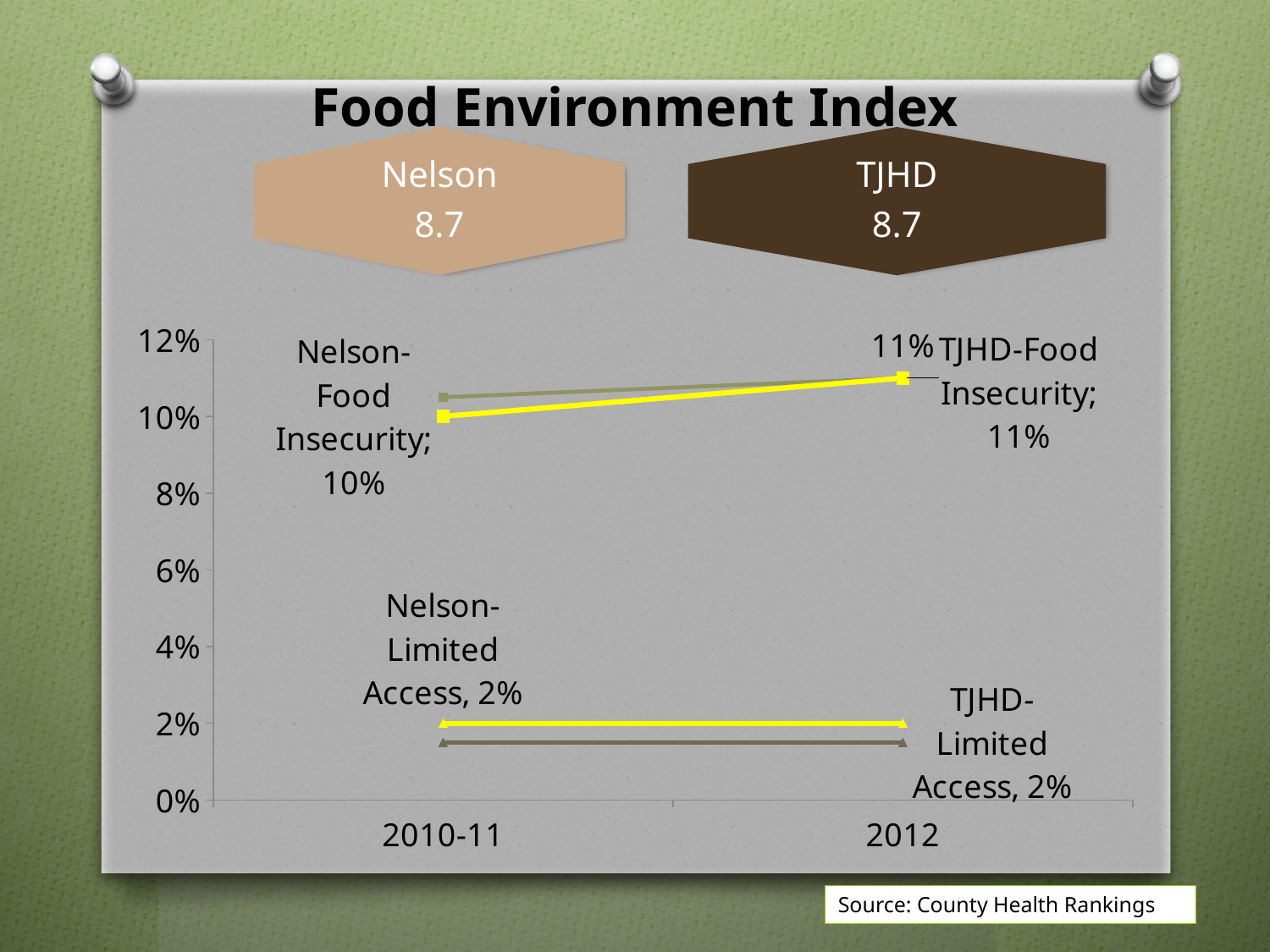
What is the TJHD Food Insecurity value for 2012? 11% What Food Environment Index value is shown for Nelson in the shape above the chart? 8.7 What is the Nelson Food Insecurity value for 2012? 11% What kind of chart is shown on the slide? line chart In 2010-11, which is larger for Nelson: Food Insecurity or Limited Access? Food Insecurity How many time periods are shown on the x axis? 2 What is the Nelson Limited Access value for 2010-11? 2% By how many percentage points did Nelson Food Insecurity change from 2010-11 (10%) to 2012 (11%)? 1 percentage point What is the TJHD Limited Access value for 2012? 2% What is the Nelson Food Insecurity value for 2010-11? 10% Is the TJHD Food Insecurity value for 2010-11 greater or less than 8%? greater Does the Nelson Food Insecurity line rise or fall from 2010-11 to 2012? rise